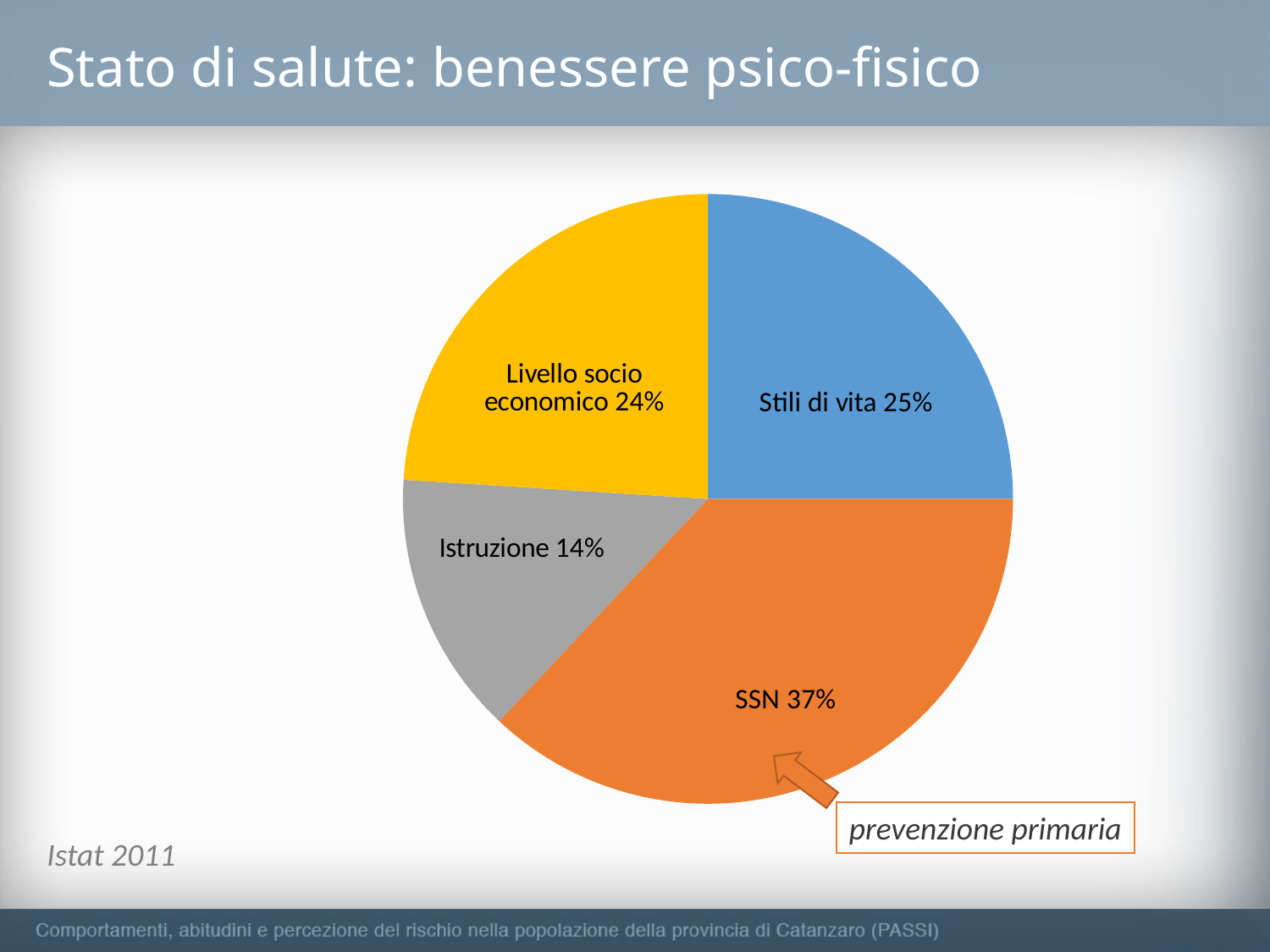
What is the value for Livello socio economico? 24% What text is in the box that the arrow points from near the SSN slice? prevenzione primaria What colour is the SSN slice? orange What is the difference between the SSN value and the Istruzione value? 23% What is the value for Istruzione? 14% Which is larger, the value for SSN or the value for Stili di vita? SSN What is the value for SSN? 37% Which slice of the pie is the largest? SSN What is the value for Stili di vita? 25% What kind of chart is shown on the slide? pie chart How many slices does the pie chart have? 4 Which slice of the pie is the smallest? Istruzione